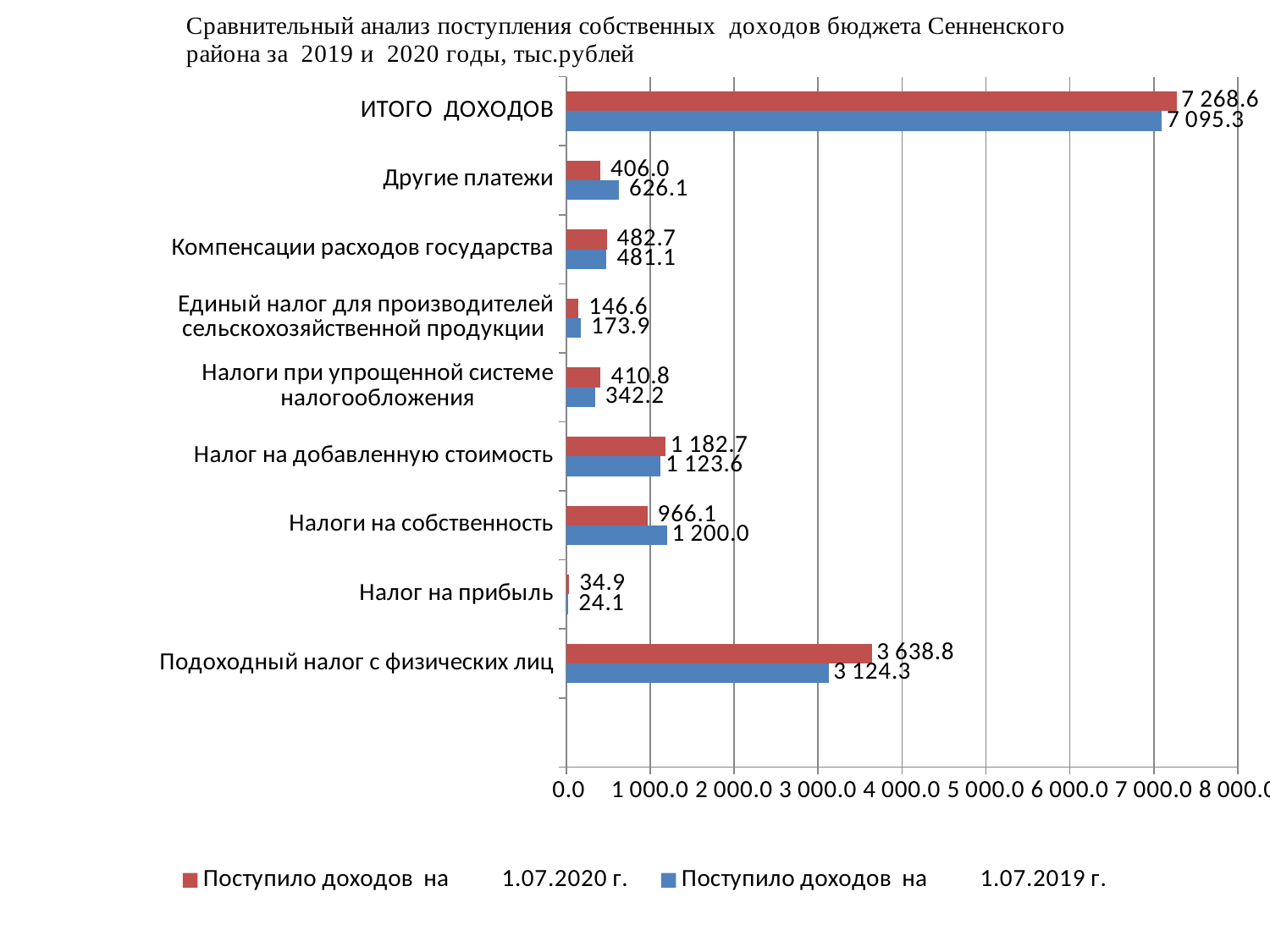
For Налоги на собственность, which series has the larger value: 'Поступило доходов на 1.07.2020 г.' or 'Поступило доходов на 1.07.2019 г.'? Поступило доходов на 1.07.2019 г. What colour represents the series 'Поступило доходов на 1.07.2019 г.'? blue What is the difference between the 2020 and 2019 values for Другие платежи? 220.1 Excluding ИТОГО ДОХОДОВ, which category has the lowest value in the series 'Поступило доходов на 1.07.2019 г.'? Налог на прибыль What is the value for Налоги на собственность in the series 'Поступило доходов на 1.07.2019 г.'? 1 200.0 What is the value for Налог на прибыль in the series 'Поступило доходов на 1.07.2020 г.'? 34.9 How many series does the legend list? 2 What type of chart is shown on the slide? bar chart What is the value for Подоходный налог с физических лиц in the series 'Поступило доходов на 1.07.2019 г.'? 3 124.3 What is the value for ИТОГО ДОХОДОВ in the series 'Поступило доходов на 1.07.2020 г.'? 7 268.6 Excluding ИТОГО ДОХОДОВ, which category has the highest value in the series 'Поступило доходов на 1.07.2020 г.'? Подоходный налог с физических лиц How many categories are shown on the vertical axis of the chart? 9